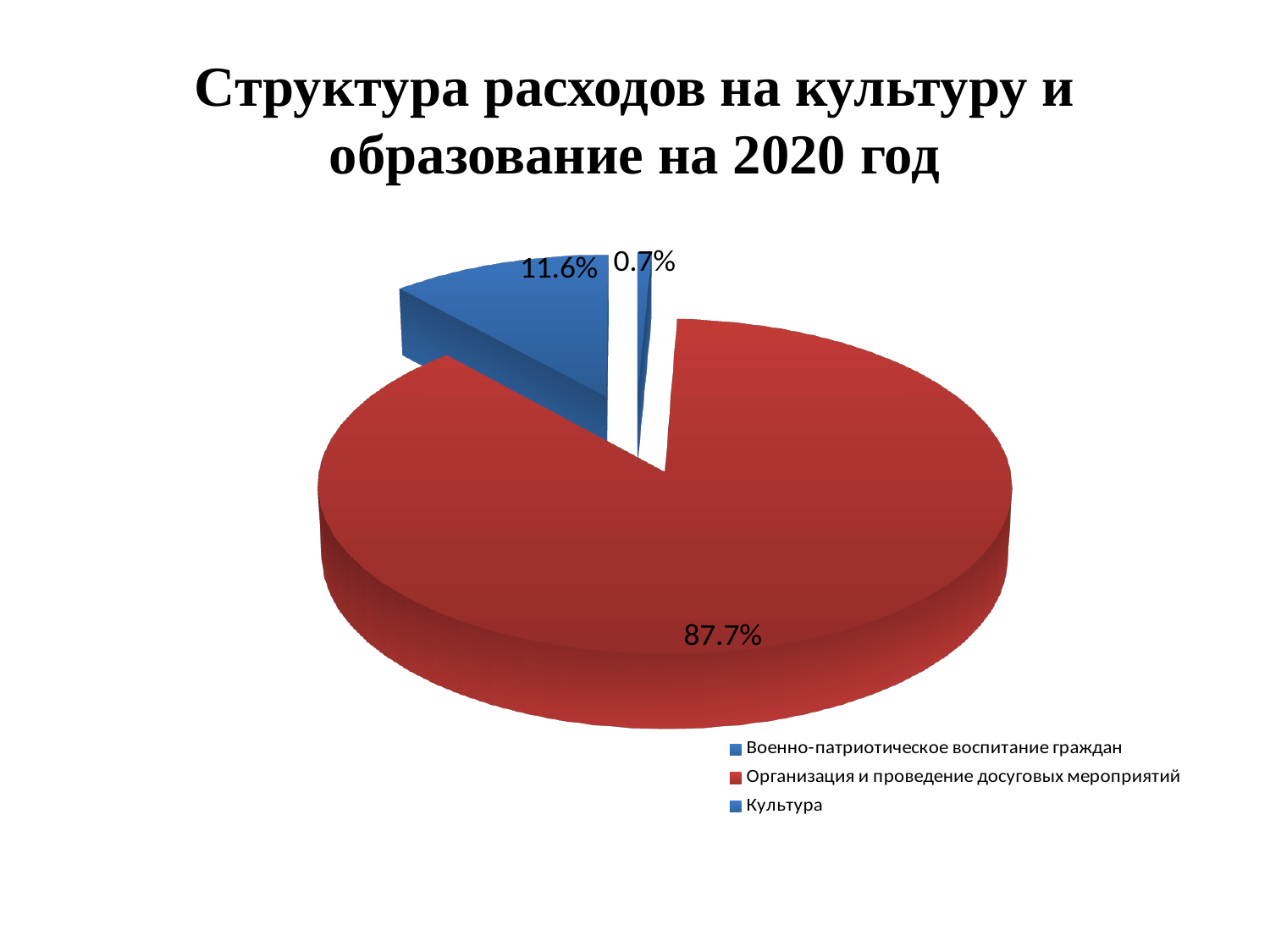
How many entries does the legend list? 3 What is the difference between the largest slice (87.7%) and the 11.6% slice? 76.1 percentage points What is the title of the slide? Структура расходов на культуру и образование на 2020 год How many slices does the pie chart have? 3 What is the difference between the 11.6% slice and the 0.7% slice? 10.9 percentage points What colour is the largest slice of the pie chart? Red What is the value of the smallest slice in the pie chart? 0.7% Which category has the largest slice of the pie? Организация и проведение досуговых мероприятий Is the share for "Организация и проведение досуговых мероприятий" greater or less than 50%? greater What share of the pie does "Организация и проведение досуговых мероприятий" take? 87.7% Which is larger: the slice for "Организация и проведение досуговых мероприятий" or the 11.6% slice? Организация и проведение досуговых мероприятий What type of chart is shown on the slide? Pie chart